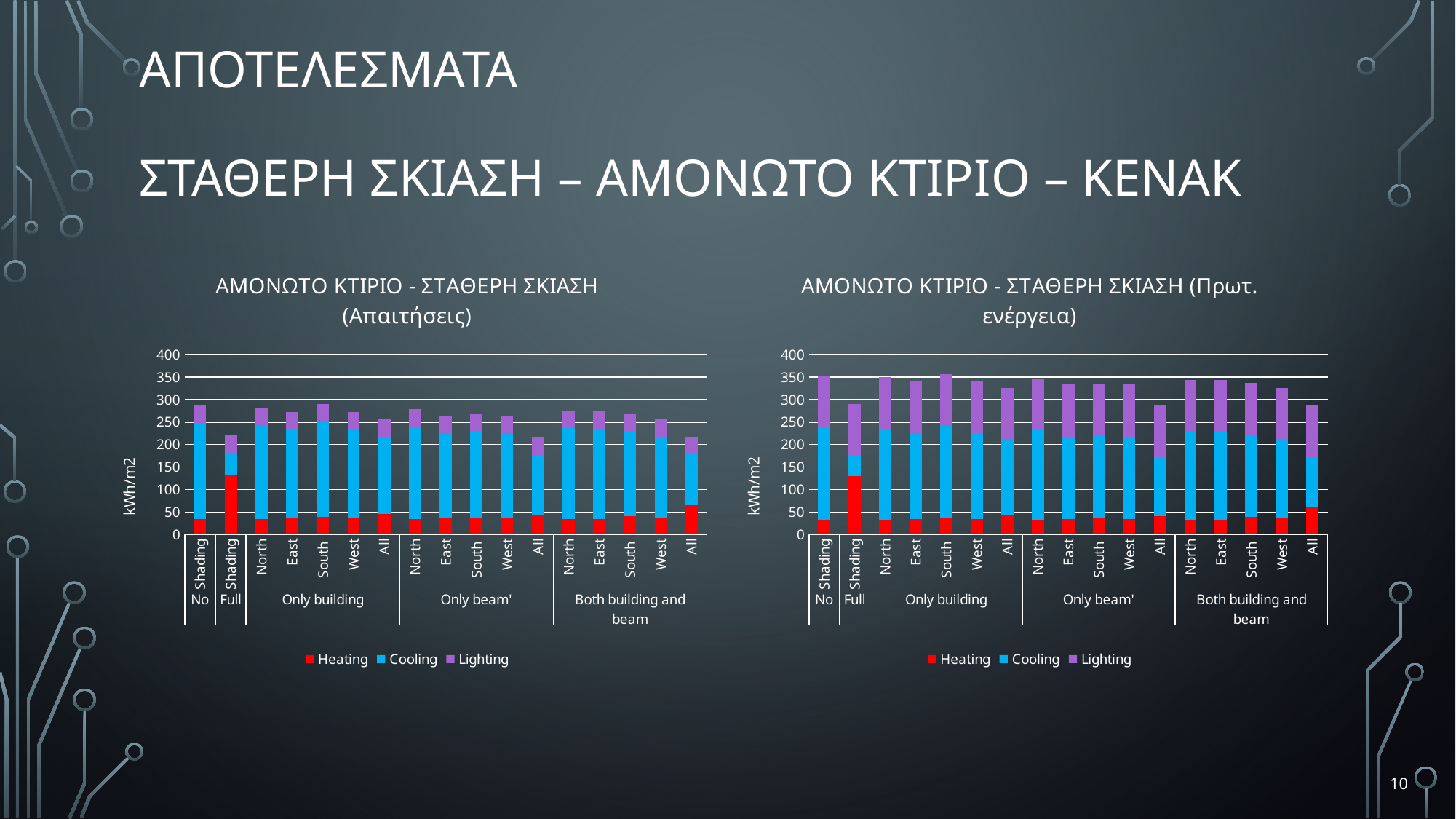
In the left chart (Απαιτήσεις), which series is shown in red? Heating In the left chart (Απαιτήσεις), is the total for No Shading greater or less than 250? greater In the right chart (Πρωτ. ενέργεια), is the total for All under Only beam' greater or less than 300? less In the right chart (Πρωτ. ενέργεια), is the total for No Shading greater or less than 300? greater How many series does the legend of the right chart, 'ΑΜΟΝΩΤΟ ΚΤΙΡΙΟ - ΣΤΑΘΕΡΗ ΣΚΙΑΣΗ (Πρωτ. ενέργεια)', list? 3 How many bars are plotted in the left chart (Απαιτήσεις)? 17 In the left chart (Απαιτήσεις), which bar has the largest Heating segment? Full Shading What is the y-axis label of the right chart (Πρωτ. ενέργεια)? kWh/m2 In the right chart (Πρωτ. ενέργεια), which bar has the largest Heating segment? Full Shading What kind of chart is the left chart, 'ΑΜΟΝΩΤΟ ΚΤΙΡΙΟ - ΣΤΑΘΕΡΗ ΣΚΙΑΣΗ (Απαιτήσεις)'? Stacked bar chart